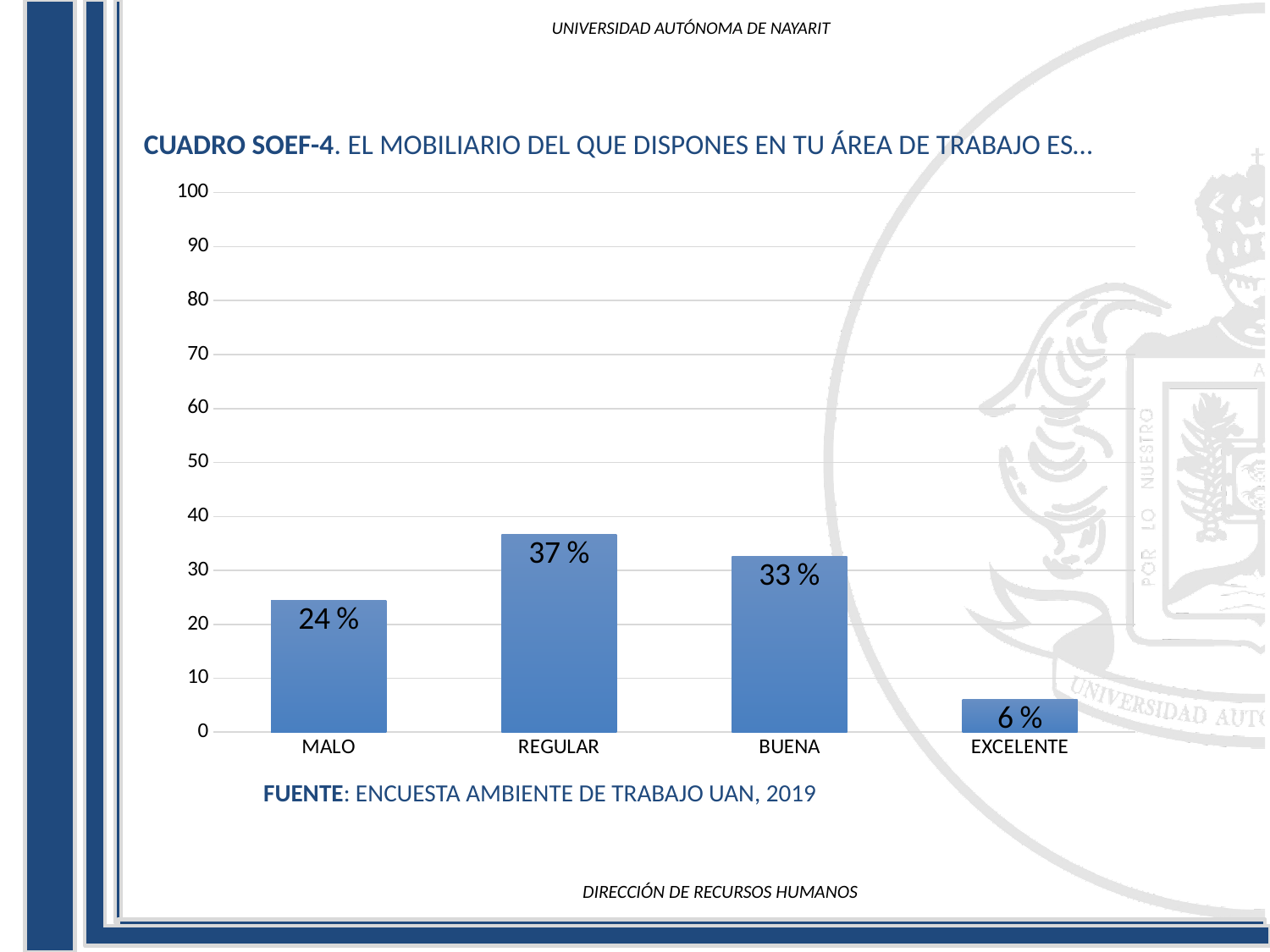
What is the difference between the values for REGULAR and BUENA? 4 % Is the value for BUENA greater or less than 40? less Which is larger, the value for MALO or the value for BUENA? BUENA How many categories are shown on the x axis? 4 What is the value for EXCELENTE? 6 % What source is cited below the chart? ENCUESTA AMBIENTE DE TRABAJO UAN, 2019 What is the value for MALO? 24 % What is the difference between the values for MALO and EXCELENTE? 18 % What is the value for REGULAR? 37 % Which category has the highest value? REGULAR What kind of chart is shown on the slide? bar chart Which category has the lowest value? EXCELENTE